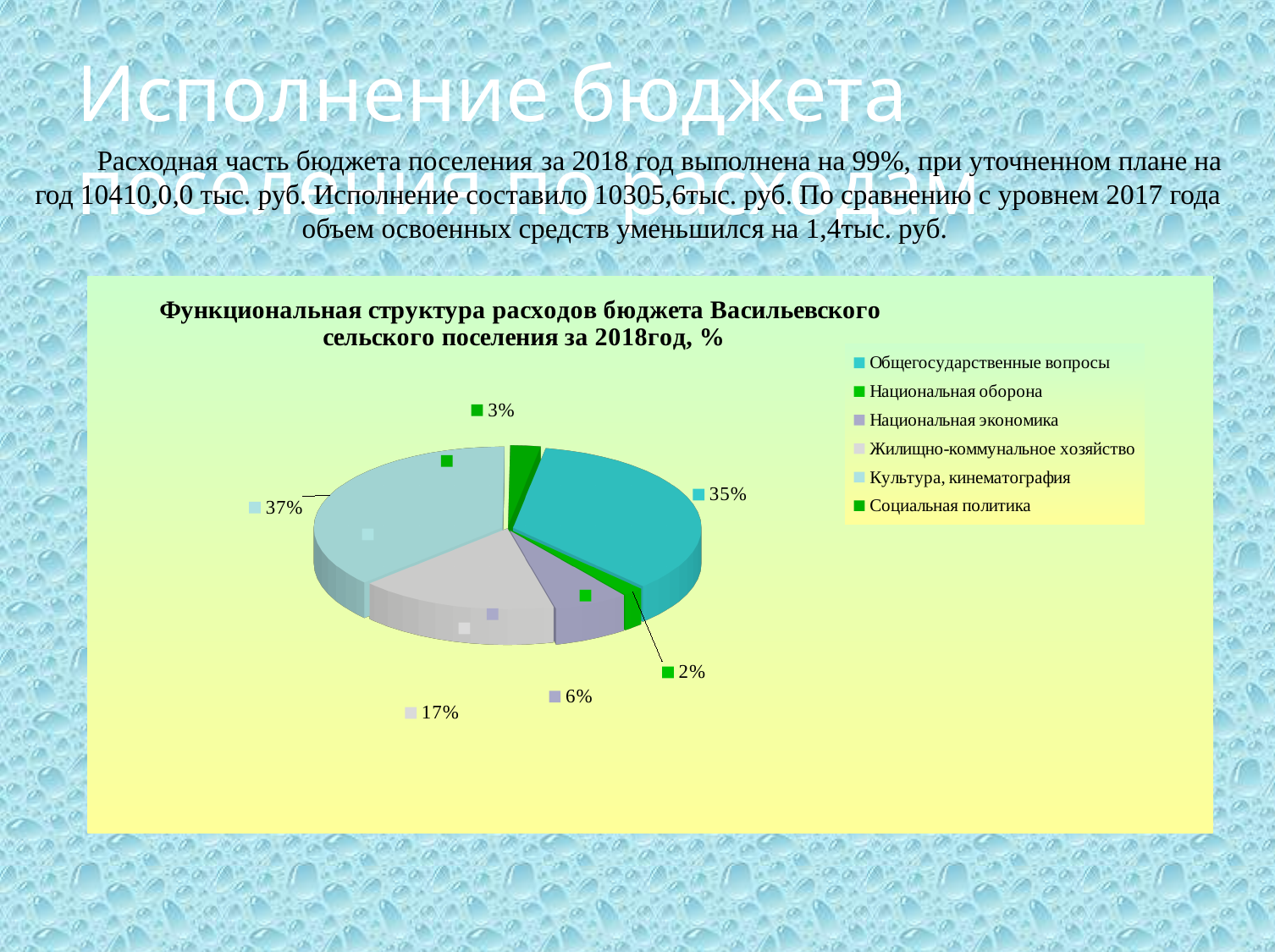
What is the title of the pie chart? Функциональная структура расходов бюджета Васильевского сельского поселения за 2018год, % Which category has the largest share of the pie? Культура, кинематография Which category has the smallest share of the pie? Национальная оборона What is the difference between the shares of Культура, кинематография and Общегосударственные вопросы? 2% Which is larger, the share of Жилищно-коммунальное хозяйство or the share of Национальная экономика? Жилищно-коммунальное хозяйство What kind of chart is shown on the slide? pie chart What share of the pie does Культура, кинематография have? 37% What share of the pie does Национальная экономика have? 6% What share of the pie does Жилищно-коммунальное хозяйство have? 17% What share of the pie does Общегосударственные вопросы have? 35% How many categories does the legend of the pie chart list? 6 What share of the pie does Социальная политика have? 3%